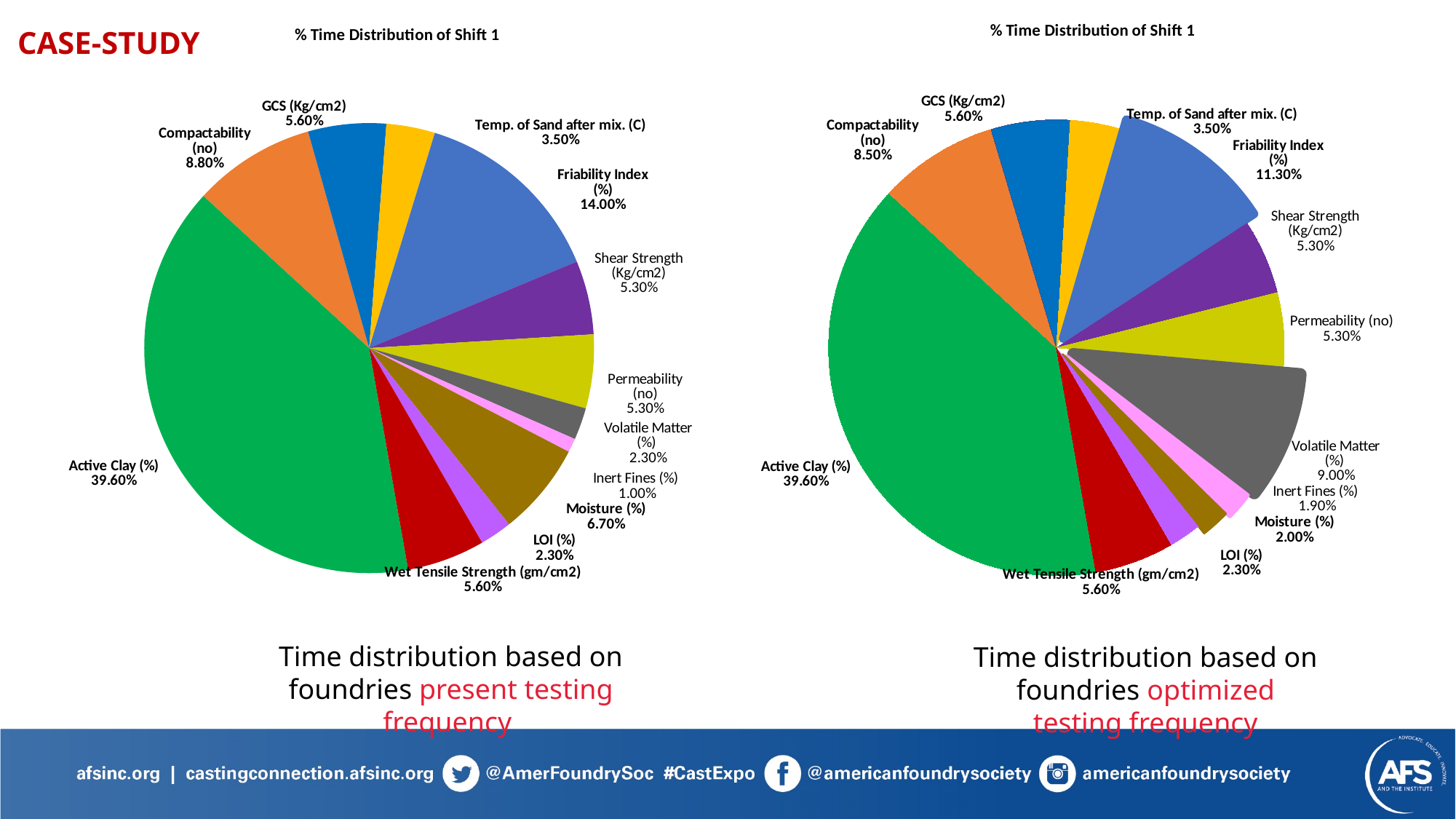
What is the title of the right pie chart? % Time Distribution of Shift 1 In the left pie chart (present testing frequency), which is larger: the Compactability (no) share or the Moisture (%) share? Compactability (no) What type of chart is used on the left side of the slide? Pie chart How many categories are shown in the right pie chart (optimized testing frequency)? 12 In the left pie chart (present testing frequency), which category has the largest share? Active Clay (%) In the right pie chart (optimized testing frequency), which category has the smallest share? Inert Fines (%) In the right pie chart (optimized testing frequency), what share of time is spent on Volatile Matter (%)? 9.00% In the right pie chart (optimized testing frequency), what is the difference between the Moisture (%) share and the Volatile Matter (%) share? 7.00% In the left pie chart (present testing frequency), what share of time is spent on Friability Index (%)? 14.00% In the left pie chart (present testing frequency), which category has the smallest share? Inert Fines (%) In the left pie chart (present testing frequency), what is the share of Moisture (%)? 6.70% What is the difference between the Friability Index (%) share in the left pie chart and in the right pie chart? 2.70%